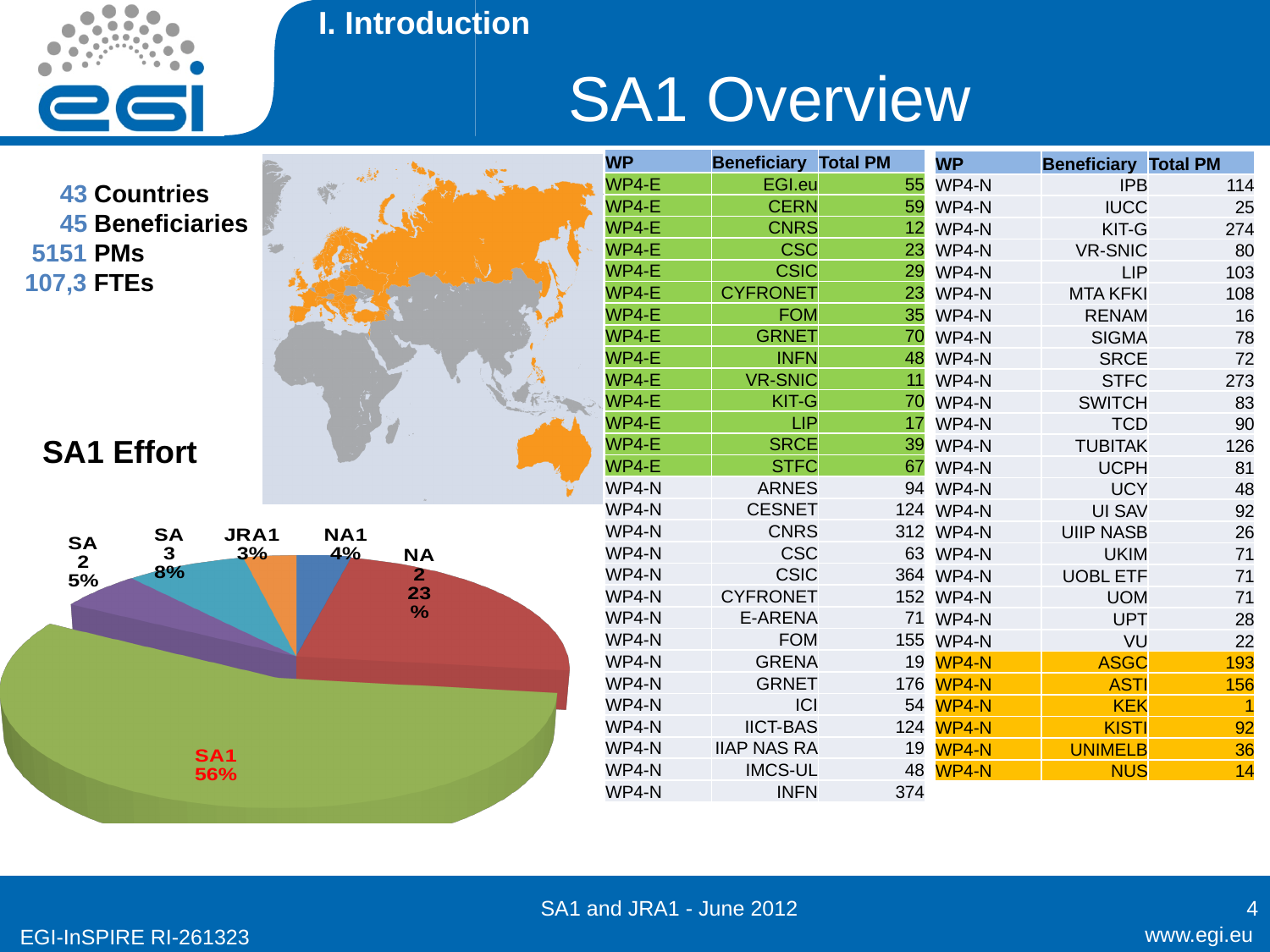
In the SA1 Effort pie chart, which is larger, SA2 or SA3? SA3 What percentage is shown for JRA1 in the SA1 Effort pie chart? 3% What share of the SA1 Effort pie chart does NA2 account for? 23% How many slices does the SA1 Effort pie chart have? 6 What share of the SA1 Effort pie chart does SA1 account for? 56% What percentage is shown for SA3 in the SA1 Effort pie chart? 8% Which slice is the largest in the SA1 Effort pie chart? SA1 Which slice is the smallest in the SA1 Effort pie chart? JRA1 What type of chart is used to show SA1 Effort? Pie chart What is the title of the chart on the slide? SA1 Effort What percentage is shown for NA1 in the SA1 Effort pie chart? 4% In the SA1 Effort pie chart, what is the difference in percentage points between SA1 and NA2? 33